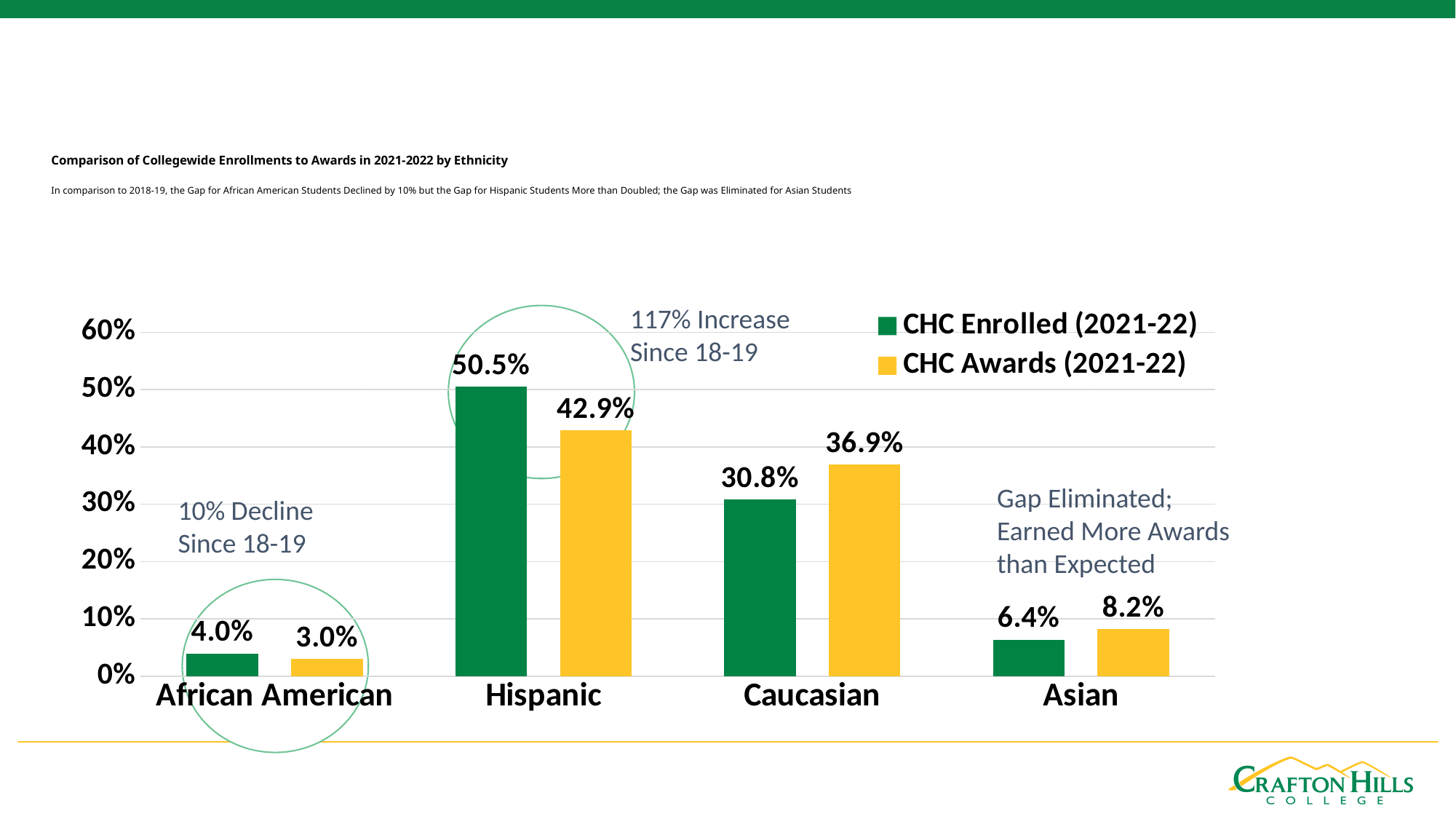
Which ethnicity has the highest CHC Enrolled (2021-22) value? Hispanic Which ethnicity has the lowest CHC Awards (2021-22) value? African American Which is larger for Asian students, CHC Enrolled (2021-22) or CHC Awards (2021-22)? CHC Awards (2021-22) What is the CHC Awards (2021-22) value for African American students? 3.0% How many series does the legend list? 2 How many ethnicity categories are shown on the x axis? 4 Is the CHC Enrolled (2021-22) value for Caucasian students greater or less than 40%? less What is the CHC Awards (2021-22) value for Caucasian students? 36.9% What is the CHC Enrolled (2021-22) value for Hispanic students? 50.5% What colour represents the CHC Awards (2021-22) series? Yellow What kind of chart is shown on the slide? Bar chart What is the difference between the CHC Enrolled and CHC Awards values for Hispanic students? 7.6%